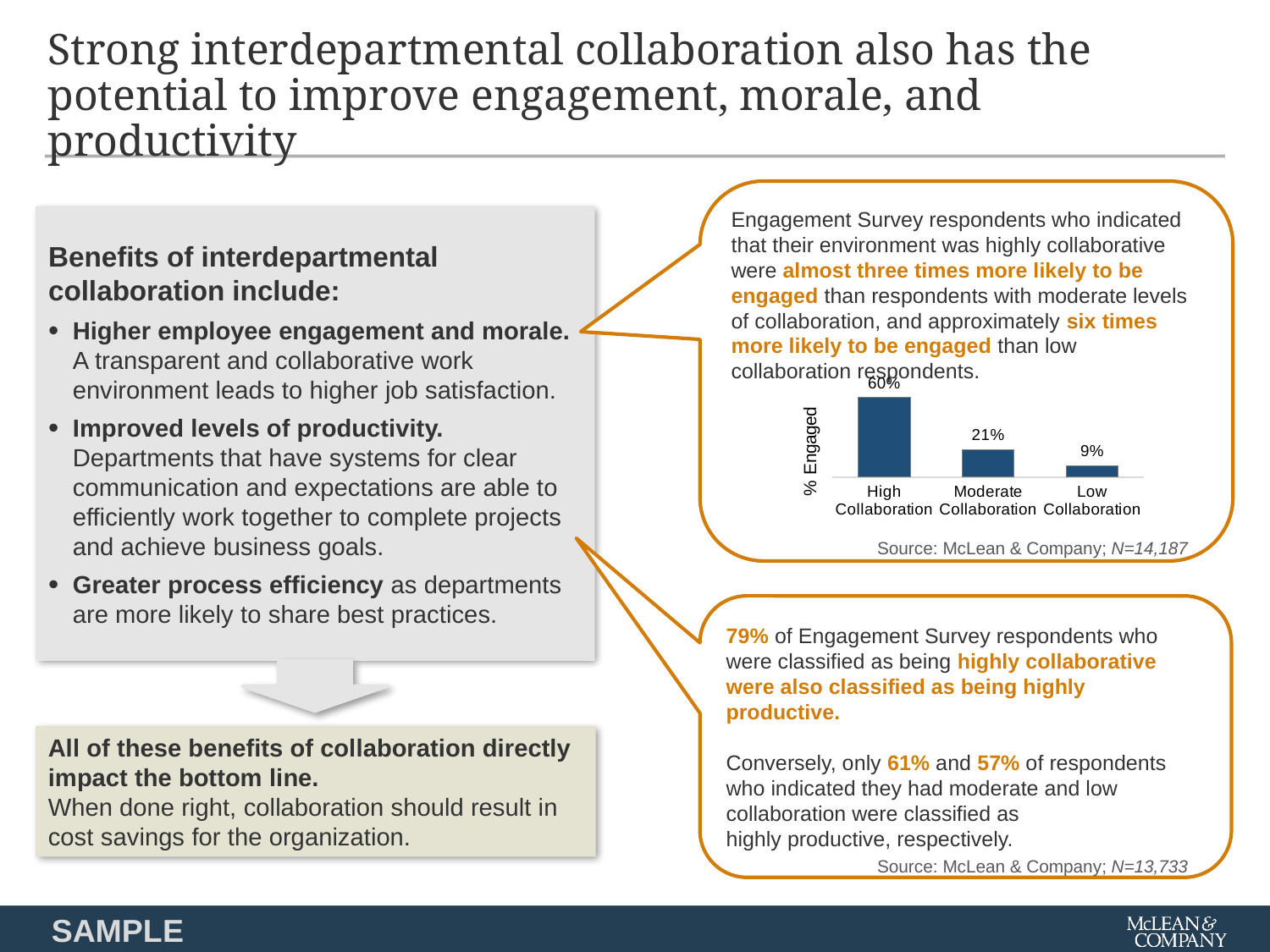
Which collaboration level has the lowest % Engaged? Low Collaboration What is the difference in % Engaged between Moderate Collaboration and Low Collaboration? 12% What is the % Engaged value for High Collaboration? 60% What is the % Engaged value for Low Collaboration? 9% Which collaboration level has the highest % Engaged? High Collaboration What type of chart is used to show % Engaged by collaboration level? Bar chart What is the % Engaged value for Moderate Collaboration? 21% What is the difference in % Engaged between High Collaboration and Moderate Collaboration? 39% How many collaboration categories are shown in the chart? 3 Do the % Engaged values rise or fall moving from High Collaboration to Low Collaboration? Fall What is the label on the vertical axis of the chart? % Engaged Which has a higher % Engaged, Moderate Collaboration or Low Collaboration? Moderate Collaboration